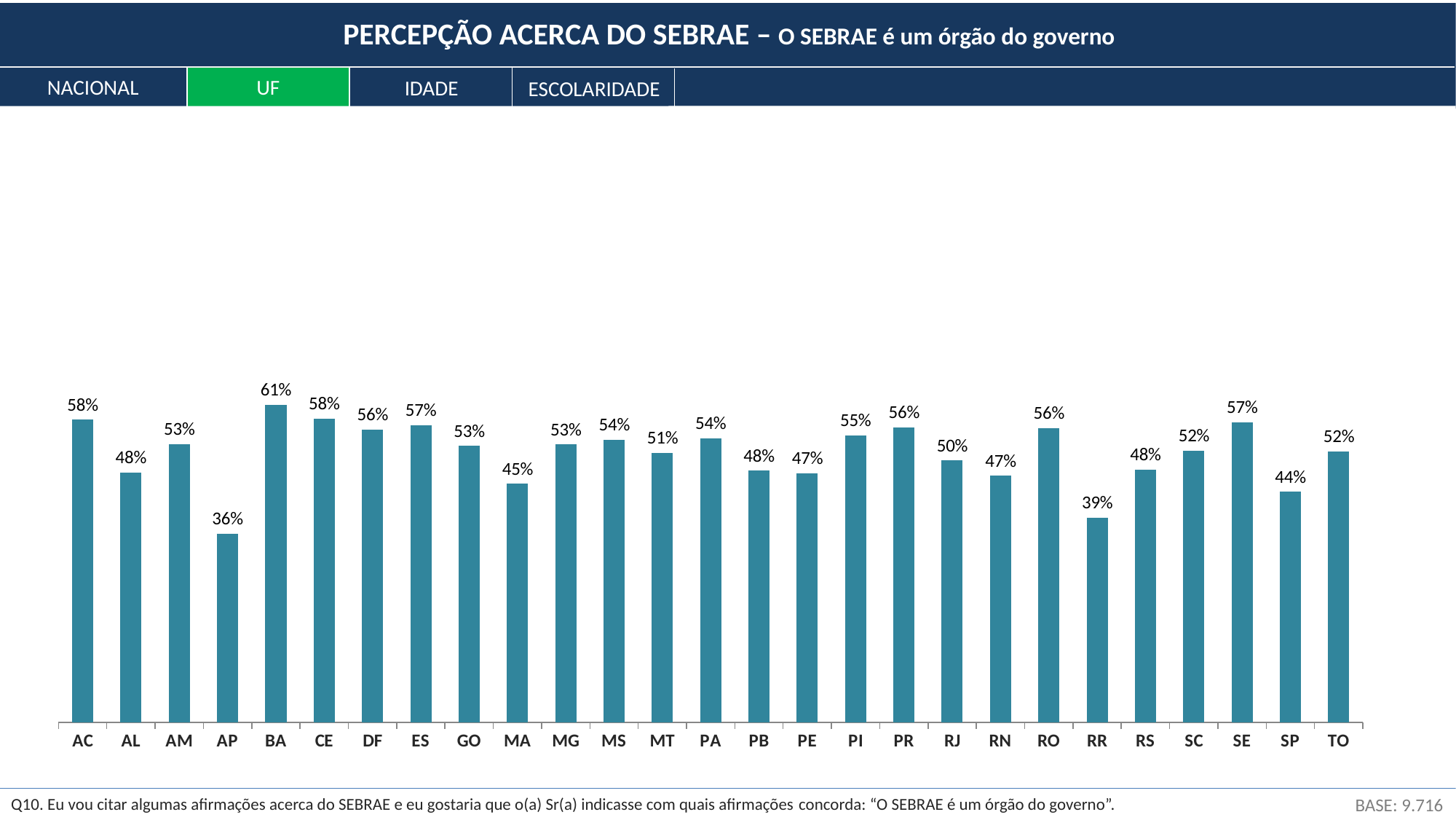
Which state has the highest value? BA What is the value for RR? 39% Which tab is highlighted in green at the top of the slide? UF What kind of chart is shown on the slide? Bar chart How many states (categories) are shown on the x axis? 27 What is the value for SP? 44% Which state has the lowest value? AP Which has a larger value, MA or MG? MG What is the difference between the values for SE and SP? 13% What is the difference between the values for BA and AP? 25% What is the value for BA? 61% What is the value for AP? 36%